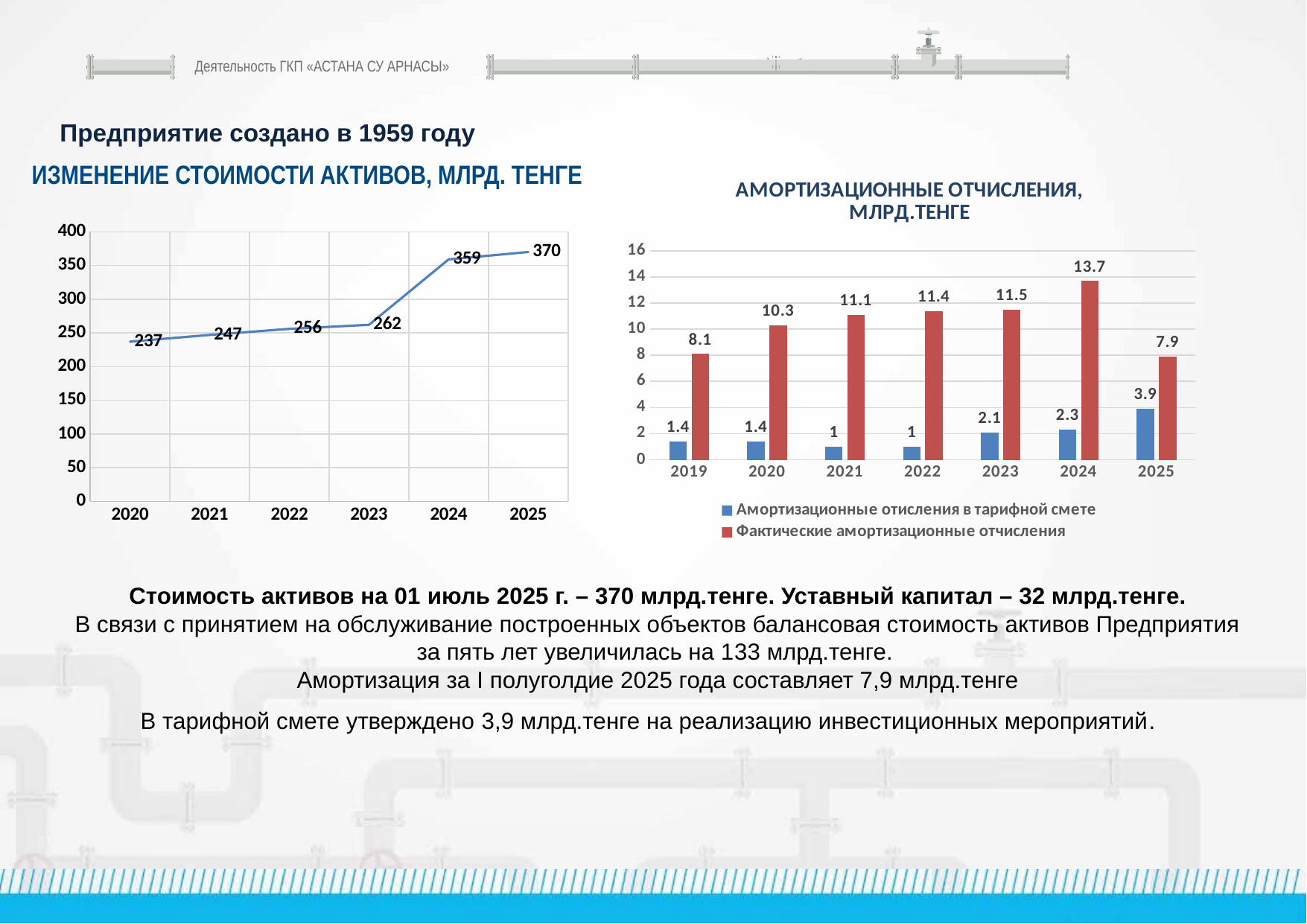
In the chart 'ИЗМЕНЕНИЕ СТОИМОСТИ АКТИВОВ, МЛРД. ТЕНГЕ', do the values rise or fall from 2020 to 2025? rise What kind of chart is 'ИЗМЕНЕНИЕ СТОИМОСТИ АКТИВОВ, МЛРД. ТЕНГЕ'? line chart In the chart 'АМОРТИЗАЦИОННЫЕ ОТЧИСЛЕНИЯ, МЛРД.ТЕНГЕ', how many years are shown on the x axis? 7 In the chart 'ИЗМЕНЕНИЕ СТОИМОСТИ АКТИВОВ, МЛРД. ТЕНГЕ', which year has the lowest value? 2020 In the chart 'АМОРТИЗАЦИОННЫЕ ОТЧИСЛЕНИЯ, МЛРД.ТЕНГЕ', which year has the lowest value for 'Фактические амортизационные отчисления'? 2025 In the chart 'ИЗМЕНЕНИЕ СТОИМОСТИ АКТИВОВ, МЛРД. ТЕНГЕ', which year has the highest value? 2025 In the chart 'АМОРТИЗАЦИОННЫЕ ОТЧИСЛЕНИЯ, МЛРД.ТЕНГЕ', what is the value of 'Амортизационные отисления в тарифной смете' for 2025? 3.9 In the chart 'АМОРТИЗАЦИОННЫЕ ОТЧИСЛЕНИЯ, МЛРД.ТЕНГЕ', what is the value of 'Фактические амортизационные отчисления' for 2024? 13.7 In the chart 'ИЗМЕНЕНИЕ СТОИМОСТИ АКТИВОВ, МЛРД. ТЕНГЕ', what is the value for 2023? 262 In the chart 'АМОРТИЗАЦИОННЫЕ ОТЧИСЛЕНИЯ, МЛРД.ТЕНГЕ', which is larger in 2019: 'Фактические амортизационные отчисления' or 'Амортизационные отисления в тарифной смете'? Фактические амортизационные отчисления In the chart 'АМОРТИЗАЦИОННЫЕ ОТЧИСЛЕНИЯ, МЛРД.ТЕНГЕ', how many series does the legend list? 2 In the chart 'ИЗМЕНЕНИЕ СТОИМОСТИ АКТИВОВ, МЛРД. ТЕНГЕ', what is the difference between the values for 2024 and 2023? 97